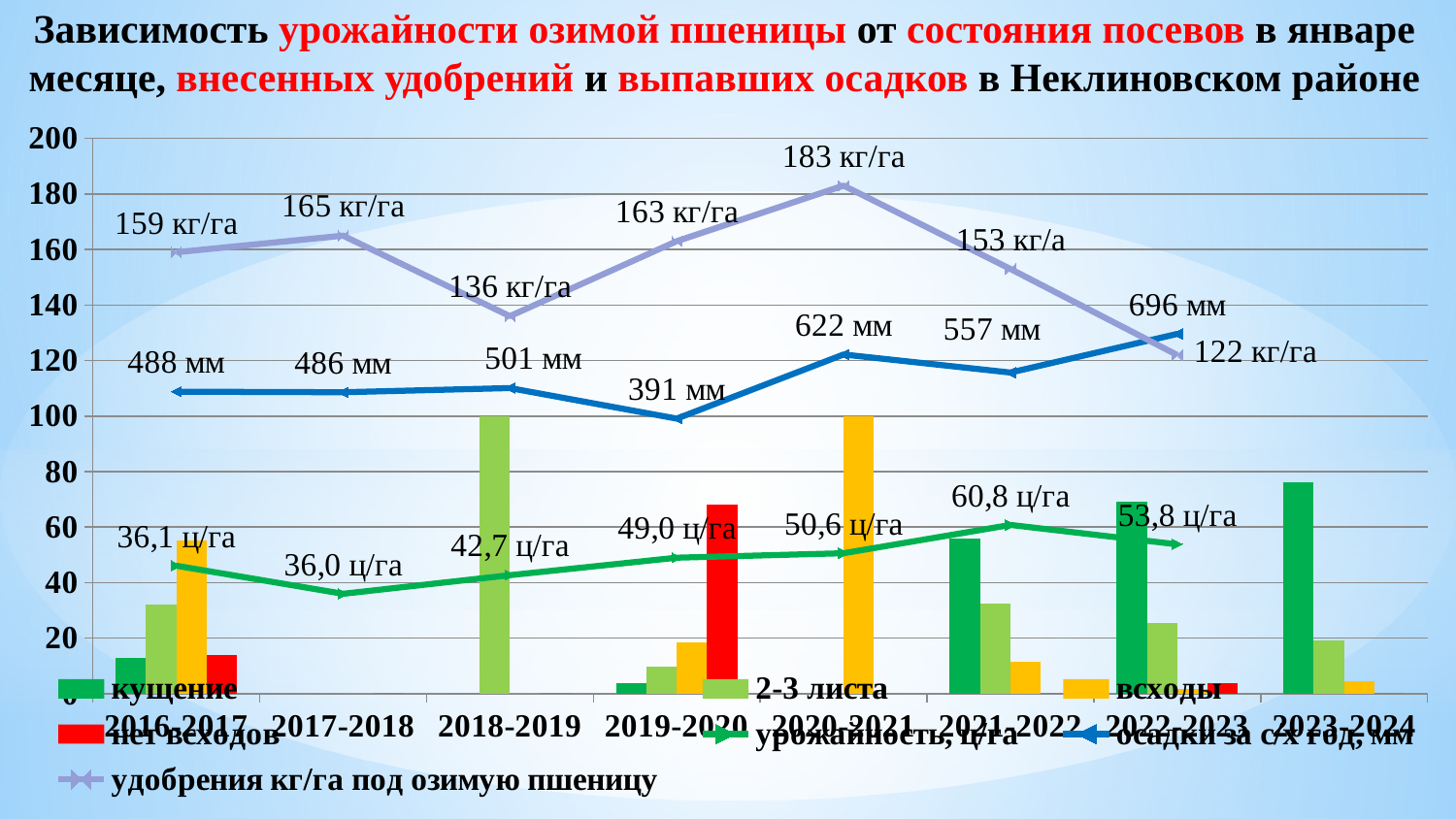
In which season is the precipitation value (осадки) lowest? 2019-2020 In which season is the fertilizer value (удобрения) highest? 2020-2021 What is the fertilizer value (удобрения) for 2020-2021? 183 кг/га How many series does the legend list? 7 How many seasons are shown on the x axis? 8 What kind of chart is shown on the slide? Combined bar and line chart What is the yield (урожайность) for 2021-2022? 60,8 ц/га Is the value of the кущение bar for 2023-2024 greater or less than 60? greater What is the precipitation value (осадки) for 2019-2020? 391 мм What is the difference between the fertilizer values for 2017-2018 and 2018-2019? 29 кг/га In which season is the yield (урожайность) highest? 2021-2022 Which season has higher precipitation: 2020-2021 or 2021-2022? 2020-2021